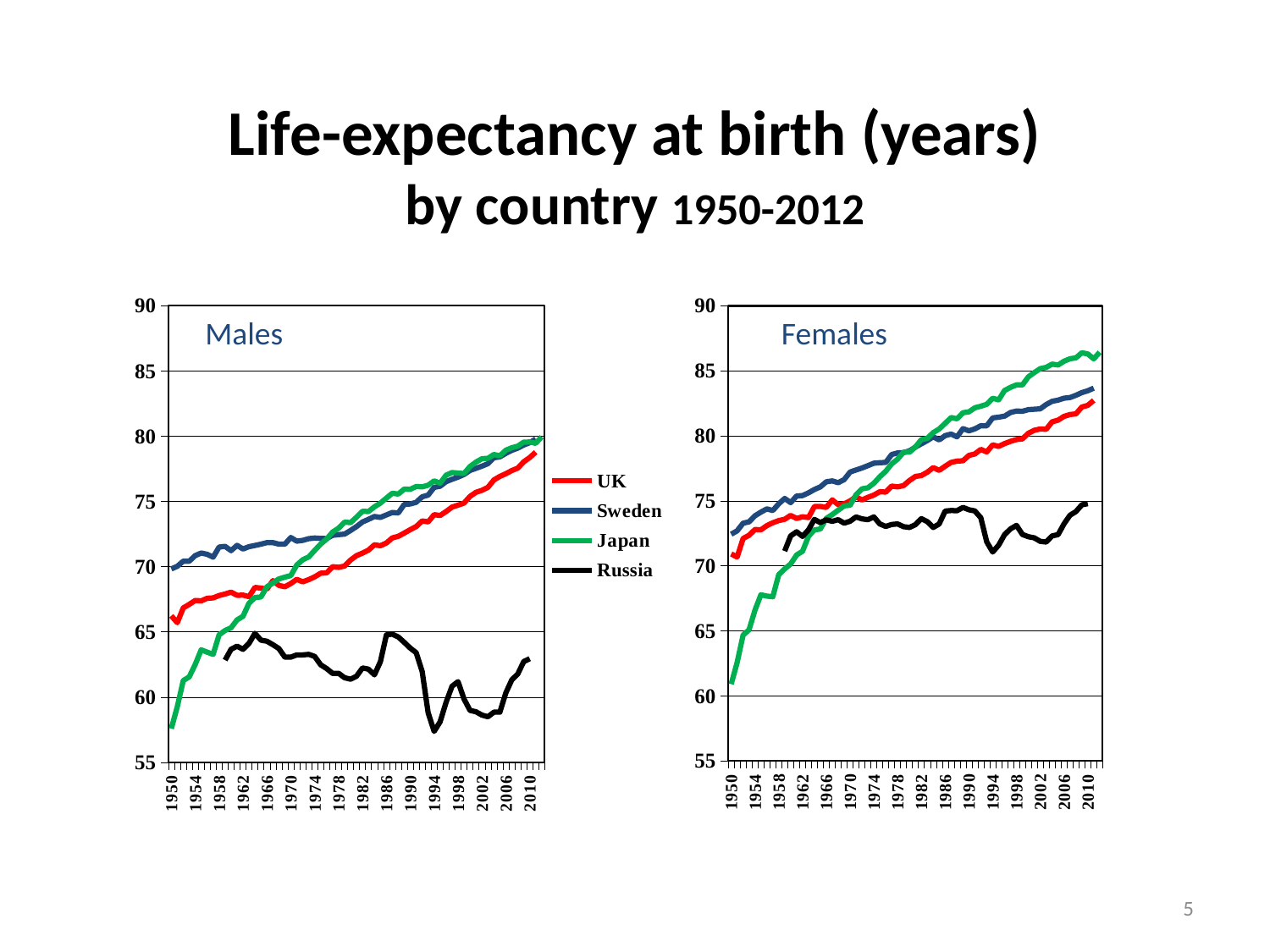
In the Females chart, is the value for Japan in 1950 greater or less than 65? less In the Males chart, which country has the lowest life expectancy in 2010? Russia In the Females chart, which country has the highest life expectancy in 2010? Japan How many series does the legend list? 4 In the Males chart, which is higher in 1950, Sweden or Japan? Sweden What kind of chart is the Males chart? line chart In the Males chart, which country has the lowest life expectancy in 1950? Japan In the Males chart, is the value for UK in 1950 greater or less than 70? less In the Males chart, is the value for Russia in 1994 greater or less than 60? less What colour is the Japan line in the legend? green In the Males chart, does the Japan line rise or fall from 1950 to 2010? rise